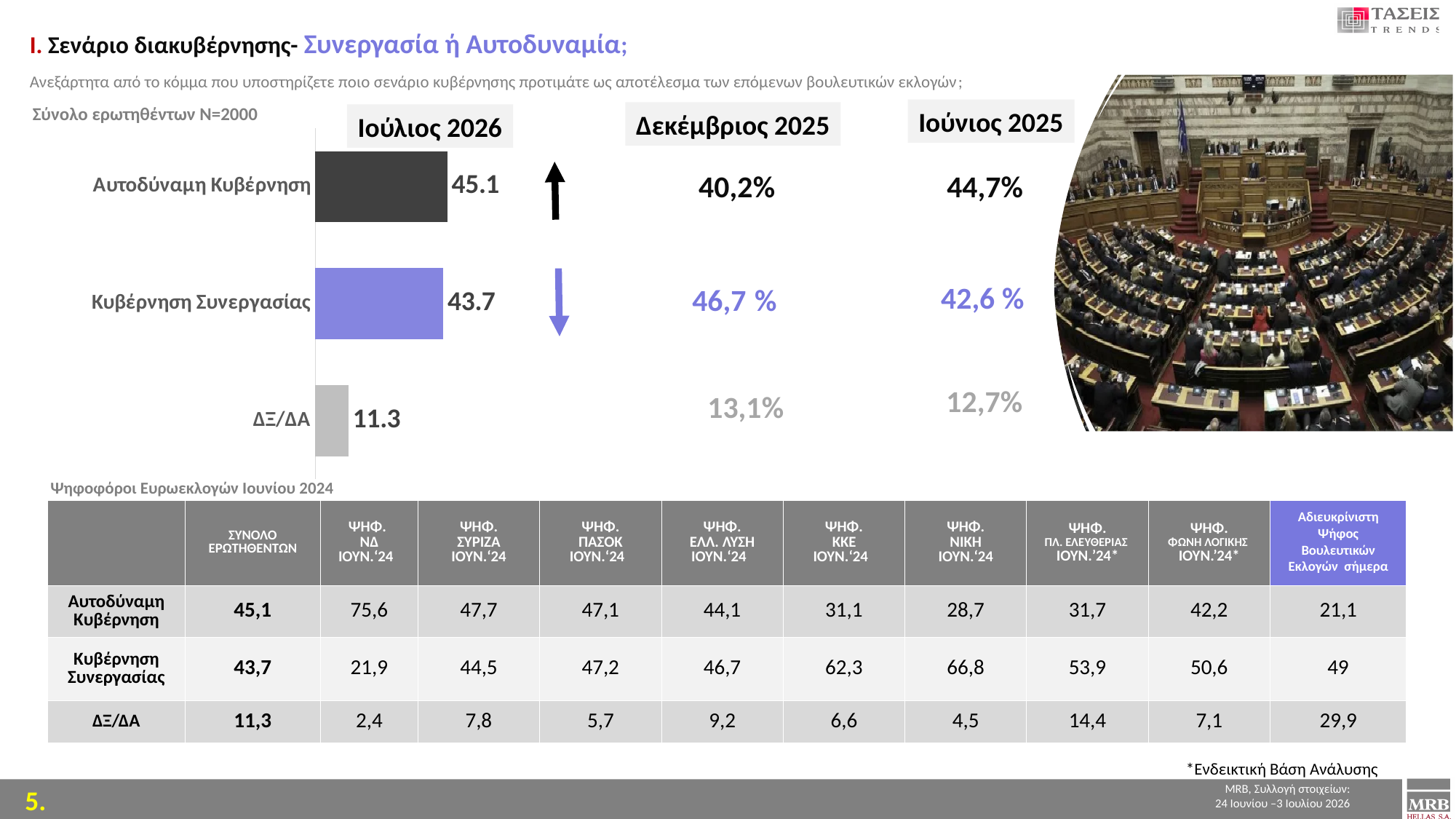
In the bar chart, what is the difference between the values for Αυτοδύναμη Κυβέρνηση and Κυβέρνηση Συνεργασίας? 1.4 In the bar chart, what is the value for Αυτοδύναμη Κυβέρνηση? 45.1 Which period does the bar chart's heading refer to? Ιούλιος 2026 Which category has the highest value in the bar chart? Αυτοδύναμη Κυβέρνηση In the bar chart, what is the value for ΔΞ/ΔΑ? 11.3 How many categories are shown in the bar chart? 3 In the bar chart, what is the value for Κυβέρνηση Συνεργασίας? 43.7 In the bar chart, what is the difference between the values for Κυβέρνηση Συνεργασίας and ΔΞ/ΔΑ? 32.4 In the bar chart, which is larger: the value for Αυτοδύναμη Κυβέρνηση or the value for Κυβέρνηση Συνεργασίας? Αυτοδύναμη Κυβέρνηση Which category has the lowest value in the bar chart? ΔΞ/ΔΑ What kind of chart is shown on the slide? Bar chart In which direction does the arrow next to the Αυτοδύναμη Κυβέρνηση bar point? Up